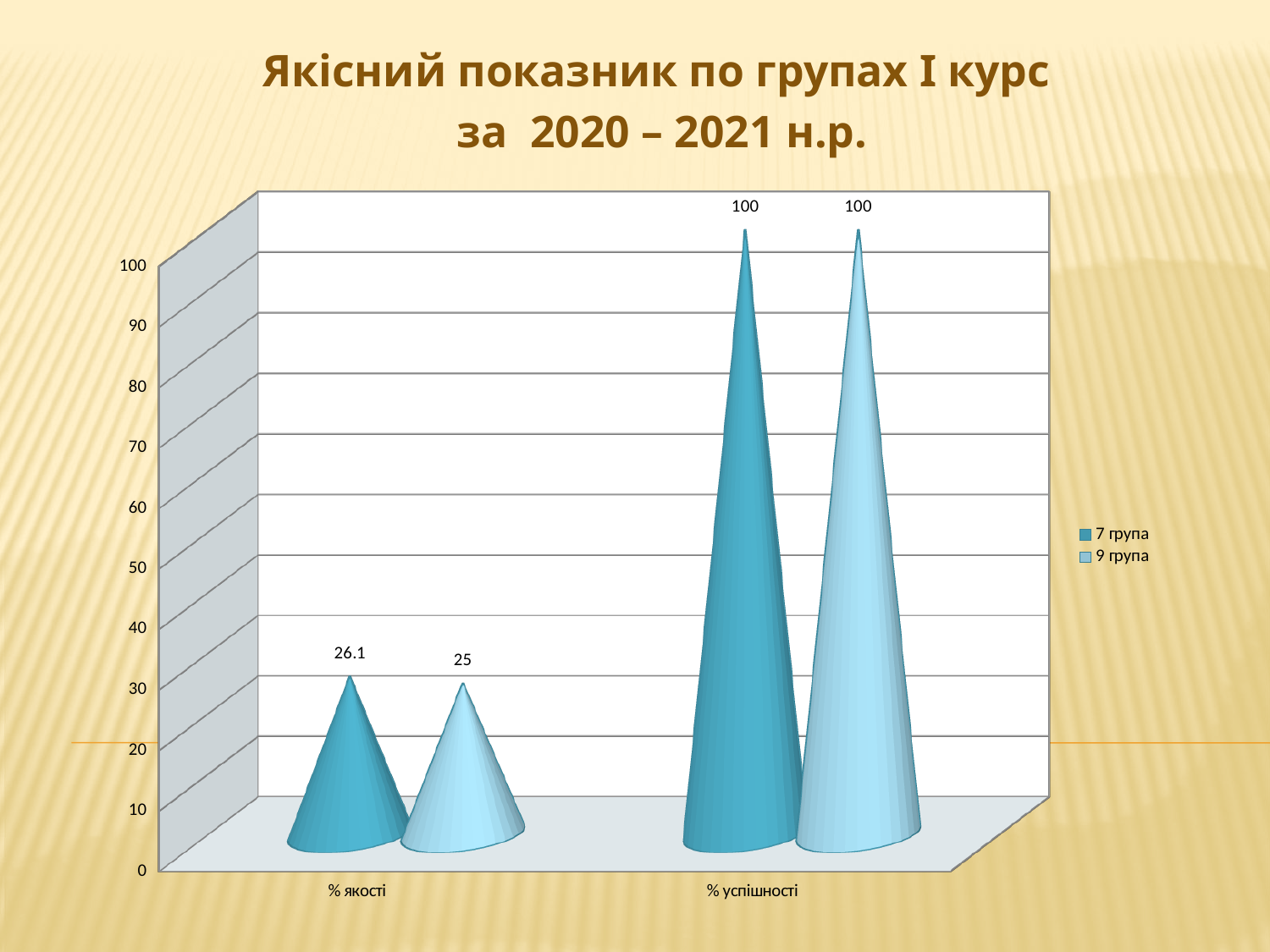
Which series has the higher value in the % якості category? 7 група What is the value for 7 група in the % якості category? 26.1 What is the value for 7 група in the % успішності category? 100 What is the value for 9 група in the % успішності category? 100 What kind of chart is shown on the slide? Bar chart How many series does the legend list? 2 What is the difference between the 7 група and 9 група values in the % якості category? 1.1 How many categories are shown on the x axis? 2 What is the difference between the % успішності and % якості values for 9 група? 75 What is the title of the chart on the slide? Якісний показник по групах І курс за 2020 – 2021 н.р. What is the value for 9 група in the % якості category? 25 Is the value for 7 група in the % якості category greater or less than 30? less